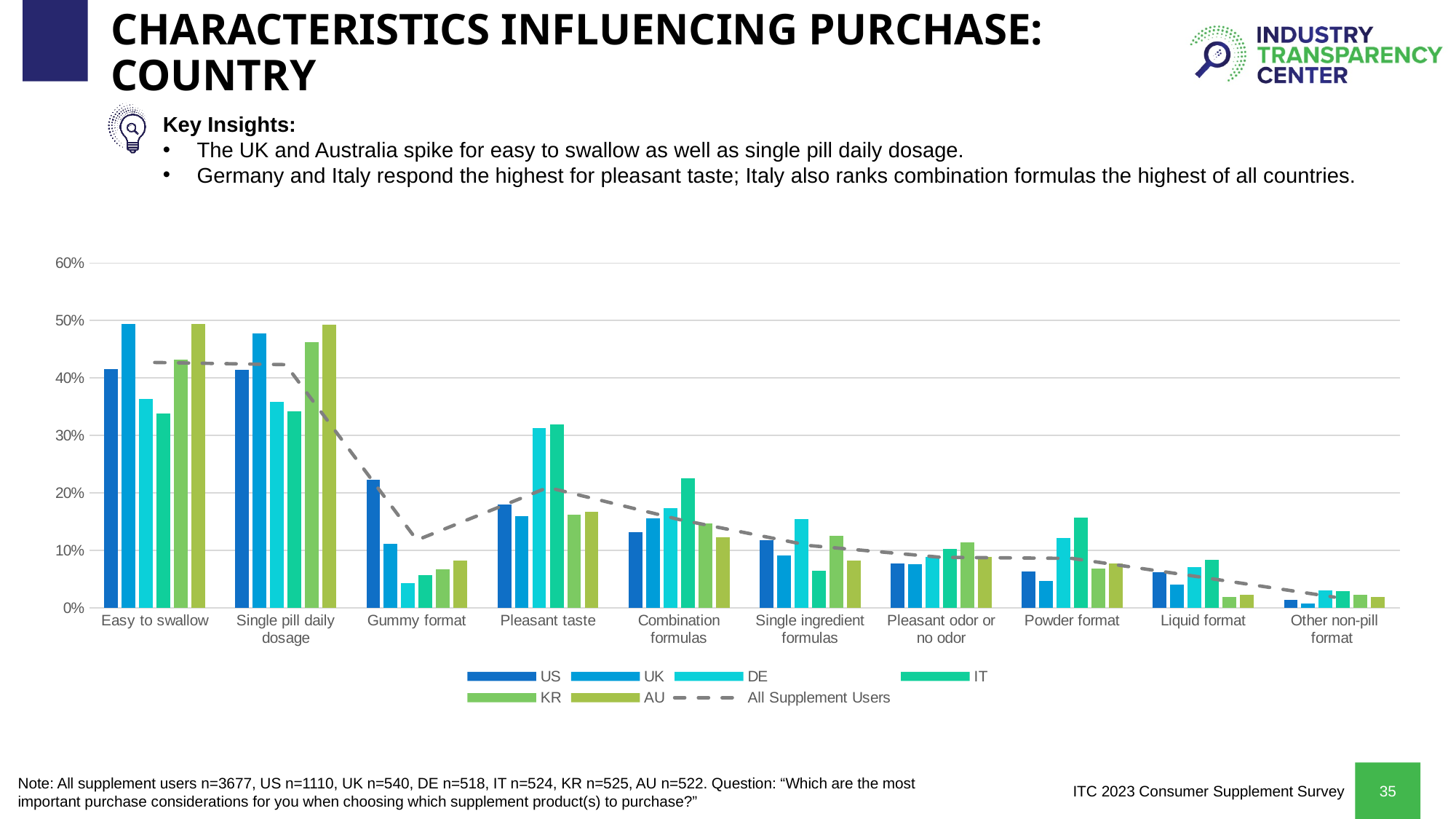
What kind of chart is shown on the slide? combination bar and line chart How many series does the legend list? 7 Is the value for KR in the Single ingredient formulas category greater or less than 10%? greater Which country has the highest value for Gummy format? US Which country has the highest value for Combination formulas? IT Is the value for UK in the Easy to swallow category greater or less than 40%? greater For Pleasant taste, which is larger: the value for DE or the value for US? DE How many purchase characteristics (categories) are shown on the x axis? 10 Which series is drawn as a dashed line rather than bars? All Supplement Users Which country has the lowest value for Powder format? UK Is the value for IT in the Gummy format category greater or less than 10%? less